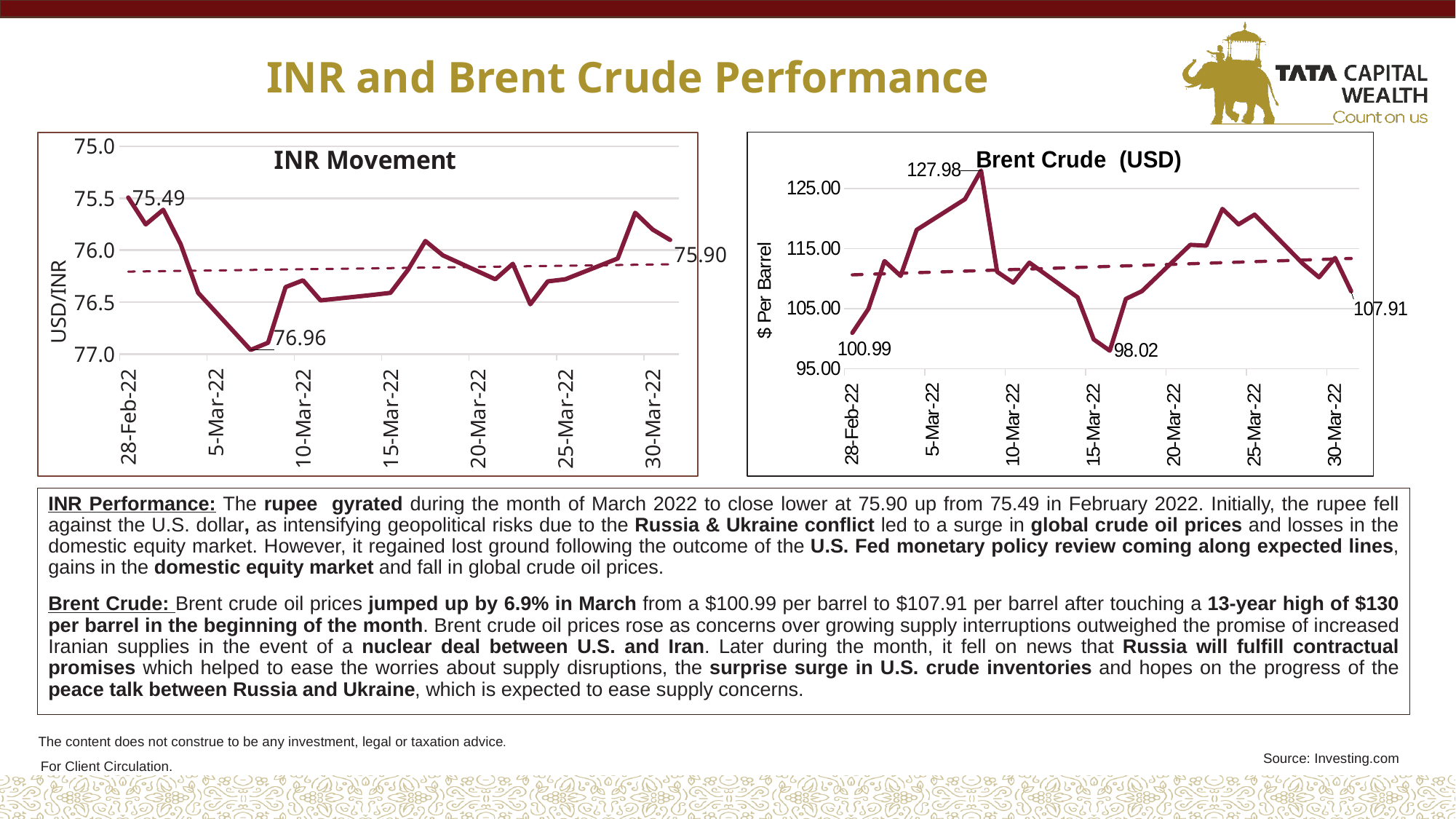
On the Brent Crude (USD) chart, what is the lowest value labelled on the line? 98.02 On the Brent Crude (USD) chart, what is the value labelled on 28-Feb-22? 100.99 On the INR Movement chart, what is the difference between the labelled values 76.96 and 75.49? 1.47 On the Brent Crude (USD) chart, what is the difference between the labelled peak of 127.98 and the labelled low of 98.02? 29.96 On the INR Movement chart, what is the value labelled at the end of the series on 30-Mar-22? 75.90 On the Brent Crude (USD) chart, is the value on 30-Mar-22 greater or less than 105.00? greater On the Brent Crude (USD) chart, what is the value labelled at the end of the series on 30-Mar-22? 107.91 What is the y-axis label on the Brent Crude (USD) chart? $ Per Barrel On the Brent Crude (USD) chart, what is the peak value labelled on the line? 127.98 What type of chart is the INR Movement chart? Line chart On the INR Movement chart, what is the value labelled at the start of the series on 28-Feb-22? 75.49 On the INR Movement chart, what is the highest USD/INR value labelled on the line? 76.96